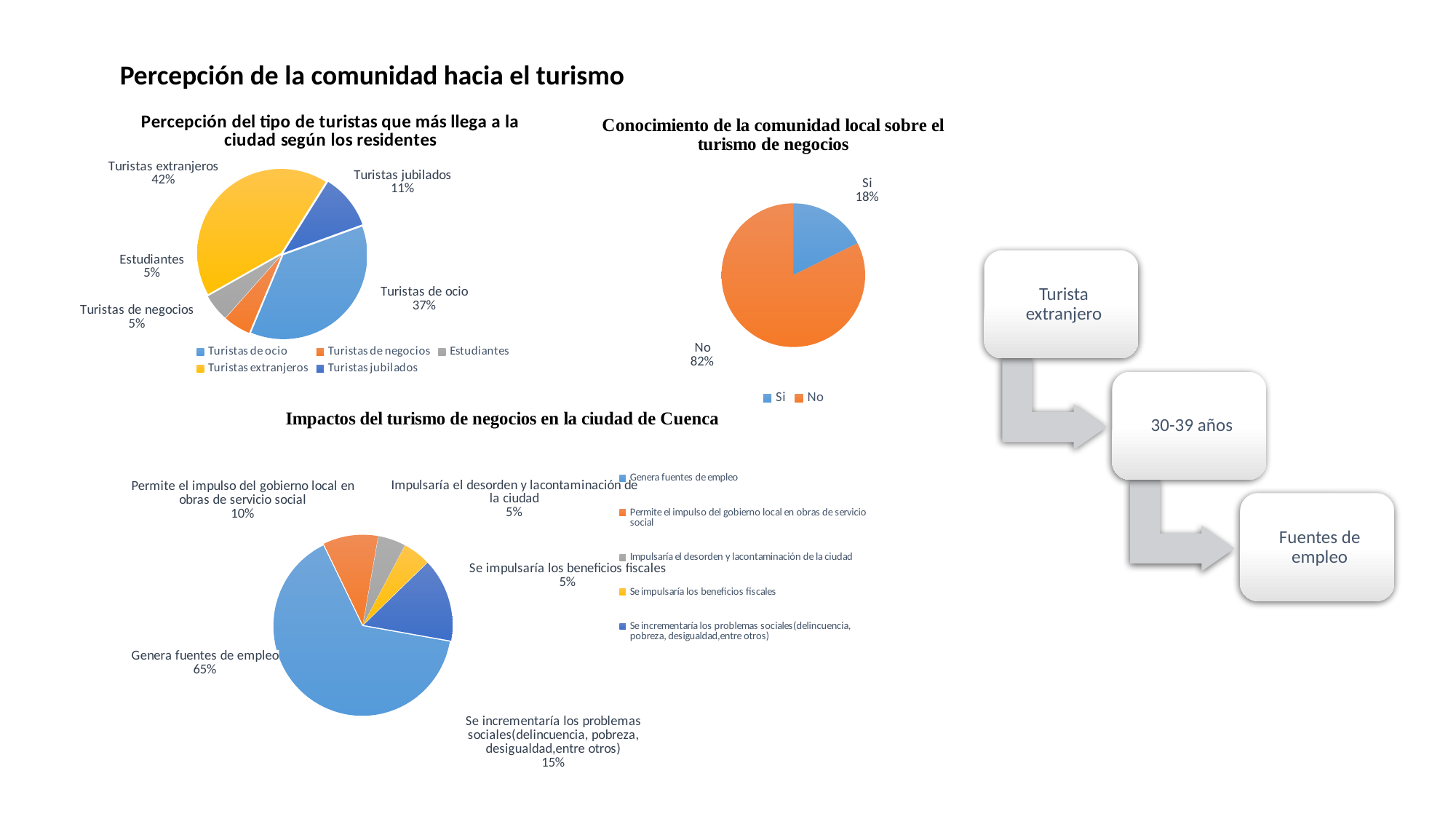
In the chart 'Conocimiento de la comunidad local sobre el turismo de negocios', which is larger, Si or No? No In the chart 'Percepción del tipo de turistas que más llega a la ciudad según los residentes', what share is Turistas extranjeros? 42% In the chart 'Impactos del turismo de negocios en la ciudad de Cuenca', what is the difference between Genera fuentes de empleo and Permite el impulso del gobierno local en obras de servicio social? 55% In the chart 'Percepción del tipo de turistas que más llega a la ciudad según los residentes', which category has the largest share? Turistas extranjeros In the chart 'Impactos del turismo de negocios en la ciudad de Cuenca', how many entries does the legend list? 5 In the chart 'Conocimiento de la comunidad local sobre el turismo de negocios', what share answered No? 82% What kind of chart is 'Conocimiento de la comunidad local sobre el turismo de negocios'? Pie chart In the chart 'Percepción del tipo de turistas que más llega a la ciudad según los residentes', what is the difference between Turistas extranjeros and Turistas de ocio? 5% In the chart 'Impactos del turismo de negocios en la ciudad de Cuenca', what share is 'Se incrementaría los problemas sociales(delincuencia, pobreza, desigualdad,entre otros)'? 15% In the chart 'Percepción del tipo de turistas que más llega a la ciudad según los residentes', what colour is the Turistas extranjeros slice? Yellow In the chart 'Percepción del tipo de turistas que más llega a la ciudad según los residentes', how many categories are shown? 5 In the chart 'Impactos del turismo de negocios en la ciudad de Cuenca', what share is Genera fuentes de empleo? 65%